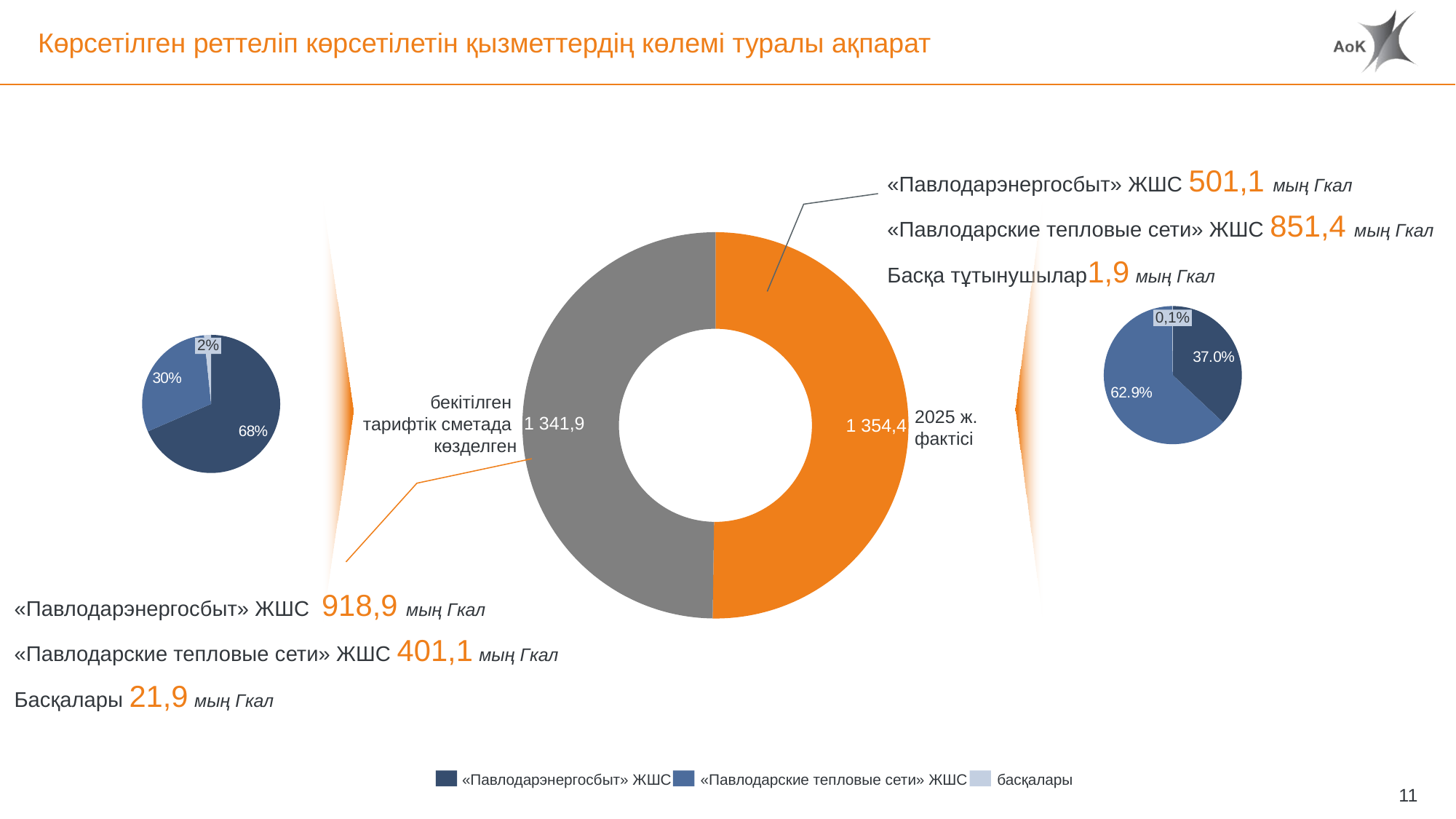
On the central donut chart, which segment is larger: "2025 ж. фактісі" or "бекітілген тарифтік сметада көзделген"? 2025 ж. фактісі On the left pie chart, what is the largest share shown? 68% On the central donut chart, how many segments are there? 2 How many entries does the legend at the bottom of the slide list? 3 On the left pie chart, what is the smallest share shown? 2% On the central donut chart, what is the difference between the "2025 ж. фактісі" value and the "бекітілген тарифтік сметада көзделген" value? 12,5 What kind of chart is the large chart in the centre of the slide? Donut chart On the right pie chart, what is the largest share shown? 62.9% On the right pie chart, what is the smallest share shown? 0,1% On the central donut chart, what value is shown for the segment labelled "бекітілген тарифтік сметада көзделген"? 1 341,9 On the central donut chart, what value is shown for the segment labelled "2025 ж. фактісі"? 1 354,4 On the right pie chart, what share is shown for the dark blue slice? 37.0%